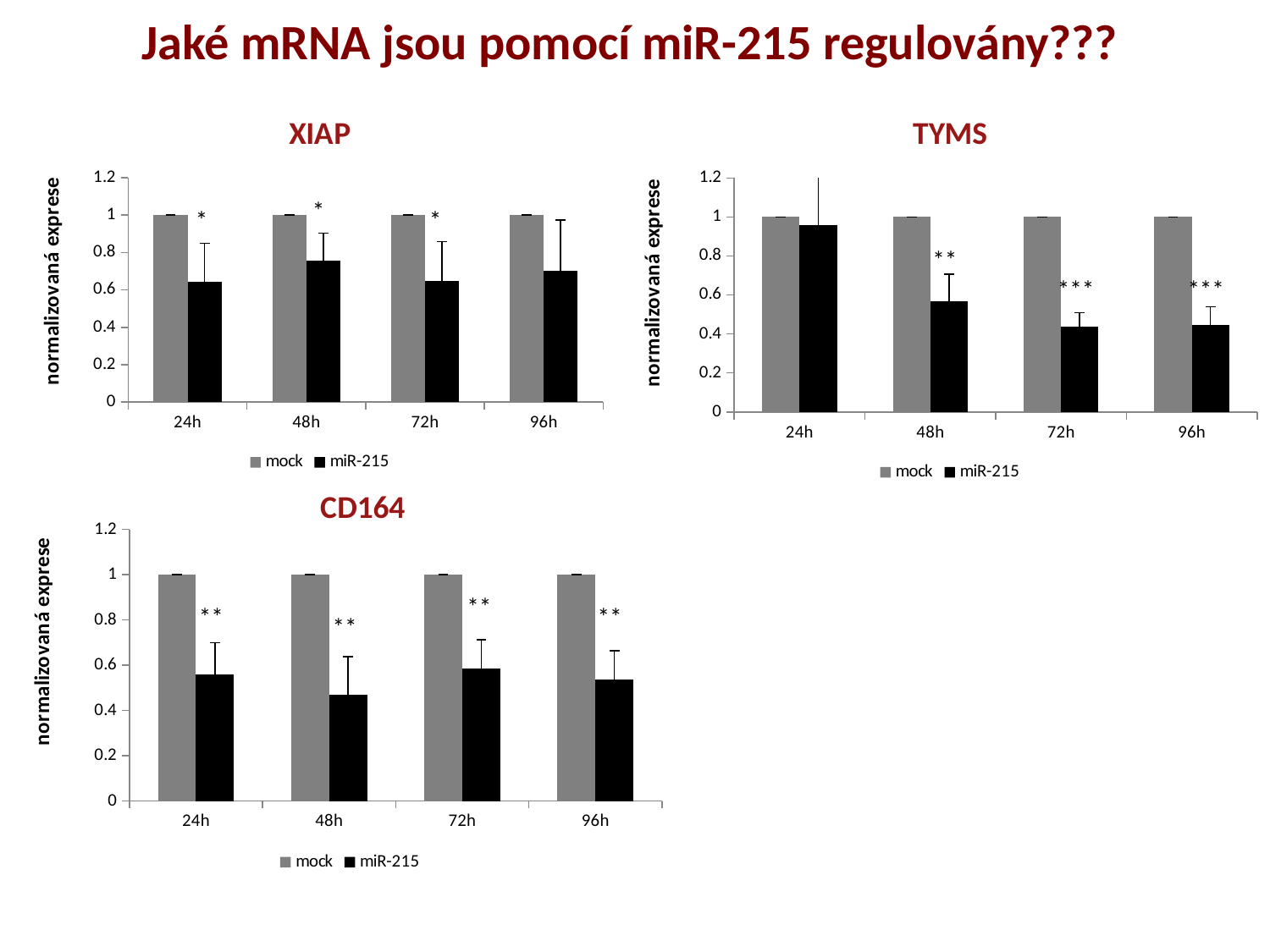
What is the y-axis title of the CD164 chart? normalizovaná exprese In the CD164 chart, at which time point is the miR-215 value lowest? 48h In the XIAP chart, is the miR-215 value at 48h greater or less than 0.6? greater In the TYMS chart, is the miR-215 value at 24h greater or less than 0.8? greater In the TYMS chart, is the miR-215 value at 72h greater or less than 0.6? less What kind of chart is the XIAP chart? bar chart In the TYMS chart, which is larger at 48h, the mock value or the miR-215 value? mock How many time-point categories are shown on the x axis of the TYMS chart? 4 How many series does the legend of the CD164 chart list? 2 In the XIAP chart, what is the normalized expression value for mock at 24h? 1 What are the two legend entries in the TYMS chart? mock and miR-215